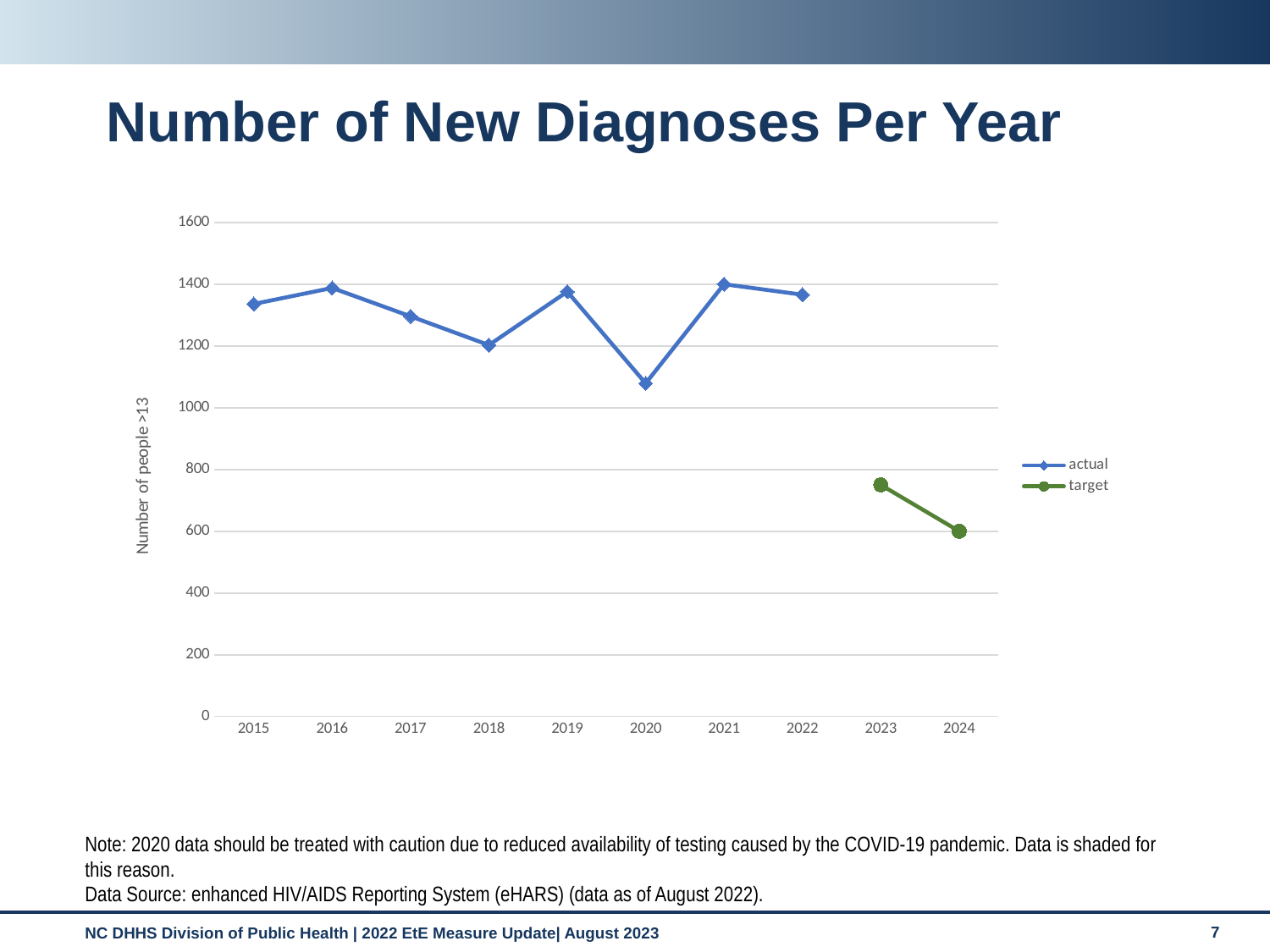
Does the target series rise or fall from 2023 to 2024? fall How many series does the legend list? 2 How many years are shown on the x axis? 10 What kind of chart is shown on the slide? line chart In which year is the actual number of new diagnoses lowest? 2020 What is the label on the y axis? Number of people >13 Which is larger, the actual value for 2018 or the actual value for 2020? 2018 What are the names of the two series in the legend? actual and target Is the actual value for 2018 greater or less than 1000? greater How many data points does the actual series have? 8 Is the target value for 2023 greater or less than 800? less Is the actual value for 2020 greater or less than 1200? less